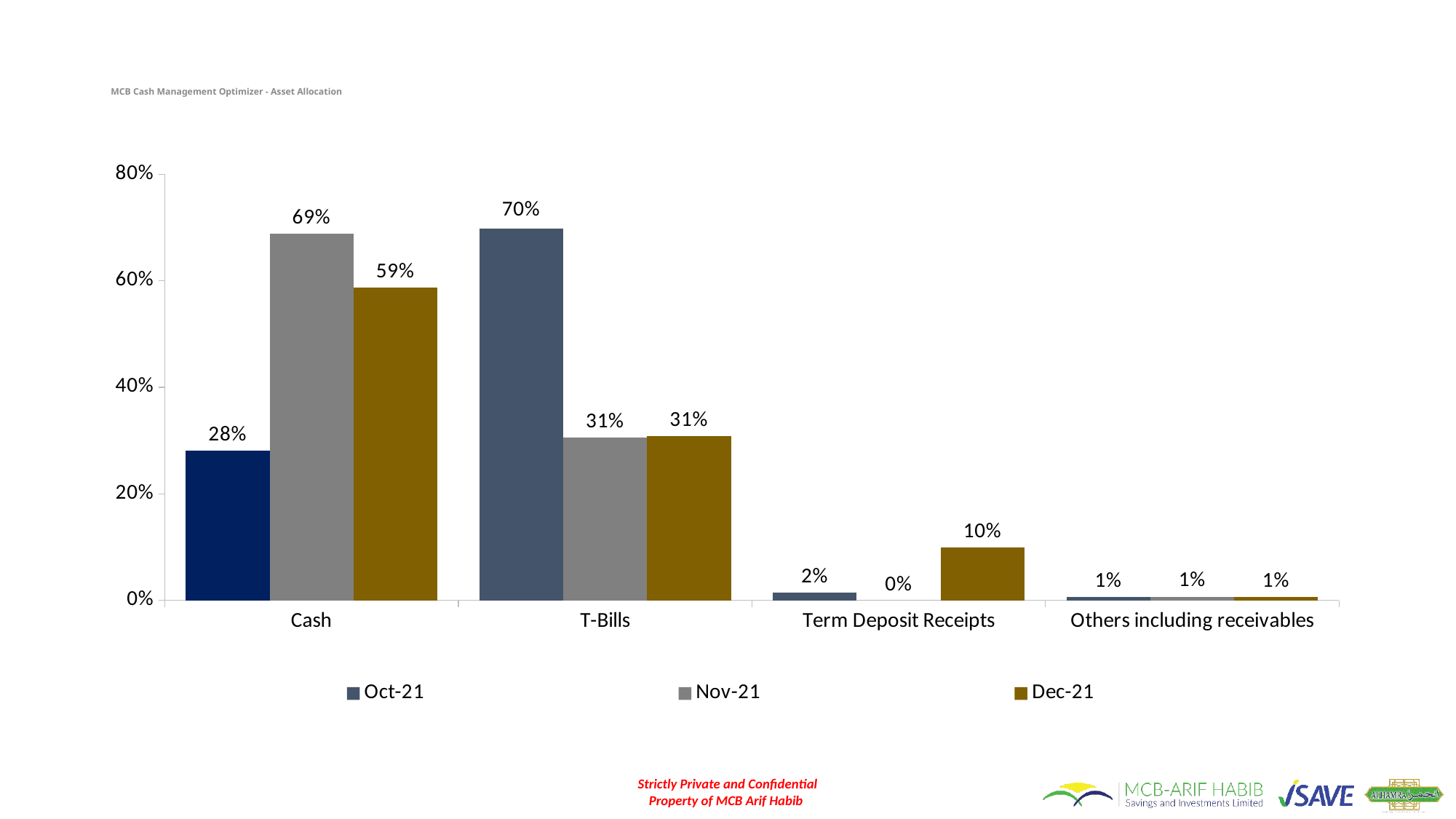
What is the title of the chart? MCB Cash Management Optimizer - Asset Allocation Which is larger: the Cash allocation for Dec-21 or the T-Bills allocation for Dec-21? Cash What is the Term Deposit Receipts allocation for Dec-21? 10% What is the difference between the Cash allocation in Nov-21 and Oct-21? 41% What is the Cash allocation for Nov-21? 69% Which category has the highest value for Oct-21? T-Bills What is the T-Bills allocation for Oct-21? 70% How many series does the legend list? 3 What kind of chart is shown on the slide? Bar chart What is the Cash allocation for Dec-21? 59% Which category has the lowest value for Nov-21? Term Deposit Receipts How many categories are shown on the x axis? 4